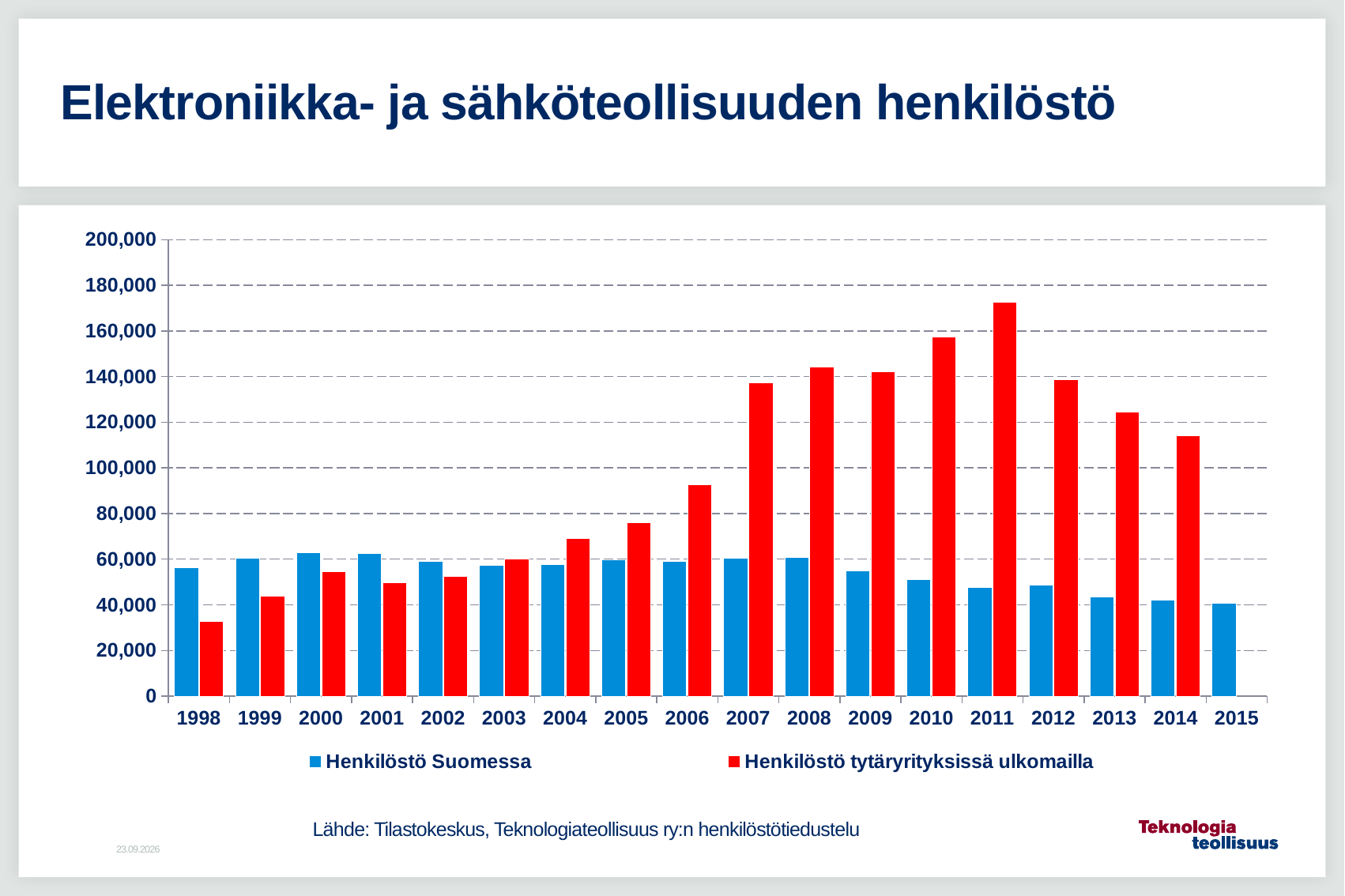
In which year is the value for Henkilöstö tytäryrityksissä ulkomailla highest? 2011 In 1998, which series has the larger value: Henkilöstö Suomessa or Henkilöstö tytäryrityksissä ulkomailla? Henkilöstö Suomessa How many series does the legend list? 2 What kind of chart is shown on the slide? bar chart Is the value for Henkilöstö tytäryrityksissä ulkomailla in 2011 greater or less than 160,000? greater Is the value for Henkilöstö Suomessa in 2013 greater or less than 60,000? less In which year is the value for Henkilöstö tytäryrityksissä ulkomailla lowest? 1998 In 2007, which series has the larger value: Henkilöstö Suomessa or Henkilöstö tytäryrityksissä ulkomailla? Henkilöstö tytäryrityksissä ulkomailla How many years are shown on the x axis? 18 Is the value for Henkilöstö tytäryrityksissä ulkomailla in 1998 greater or less than 40,000? less Does the value for Henkilöstö Suomessa rise or fall from 2008 to 2015? fall